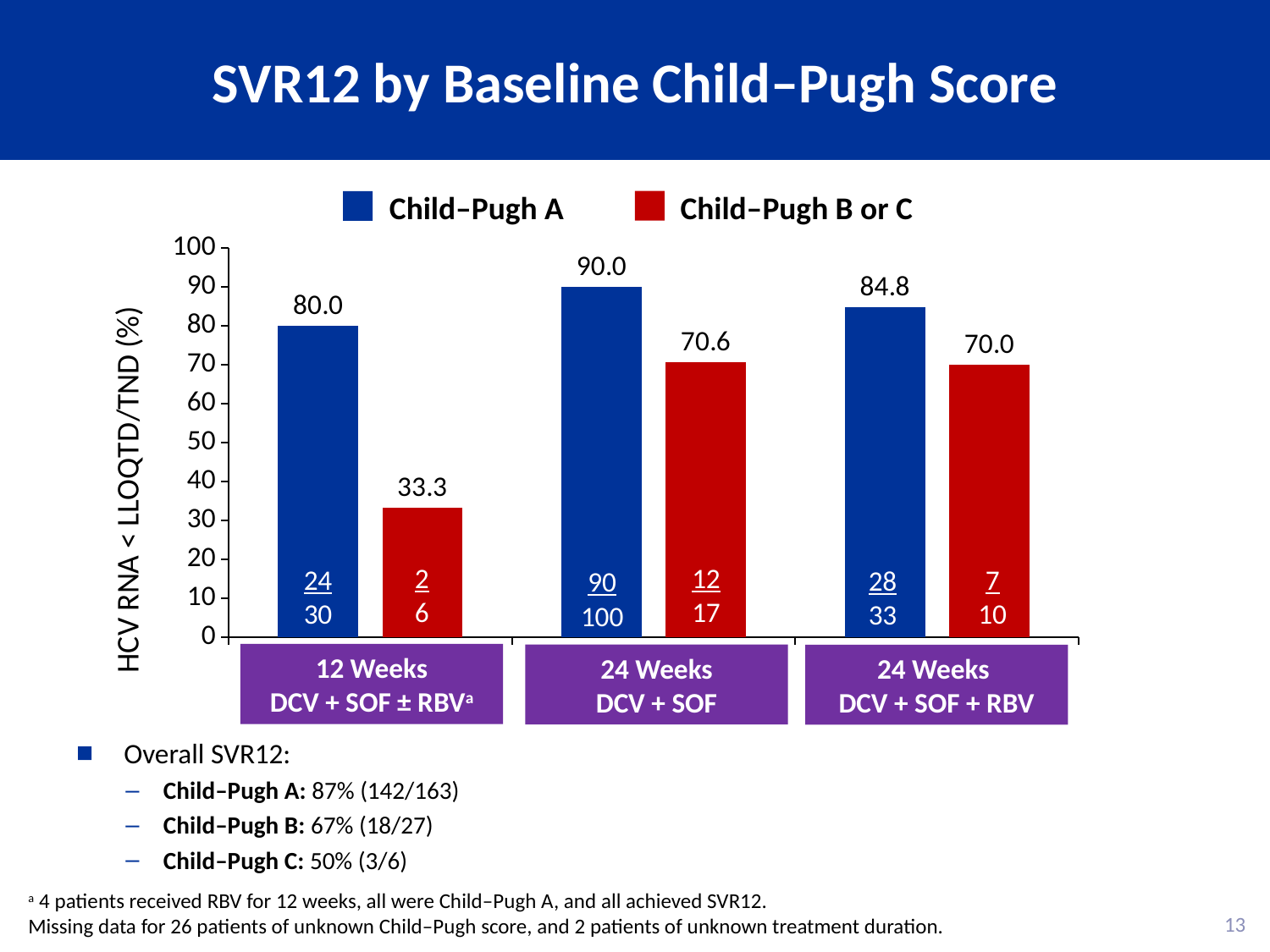
What is the SVR12 value for Child–Pugh A in the 12 Weeks DCV + SOF ± RBV group? 80.0 Which treatment group has the highest Child–Pugh A SVR12 value? 24 Weeks DCV + SOF What is the difference between the Child–Pugh A and Child–Pugh B or C values in the 12 Weeks DCV + SOF ± RBV group? 46.7 How many treatment groups are shown on the x axis? 3 Which treatment group has the lowest Child–Pugh B or C SVR12 value? 12 Weeks DCV + SOF ± RBV What is the difference between the Child–Pugh A and Child–Pugh B or C values in the 24 Weeks DCV + SOF + RBV group? 14.8 What colour represents Child–Pugh B or C in the chart? Red Which is larger in the 24 Weeks DCV + SOF group: the Child–Pugh A value or the Child–Pugh B or C value? Child–Pugh A What is the SVR12 value for Child–Pugh B or C in the 24 Weeks DCV + SOF group? 70.6 What kind of chart is shown on the slide? Bar chart What is the SVR12 value for Child–Pugh A in the 24 Weeks DCV + SOF + RBV group? 84.8 How many series does the legend list? 2